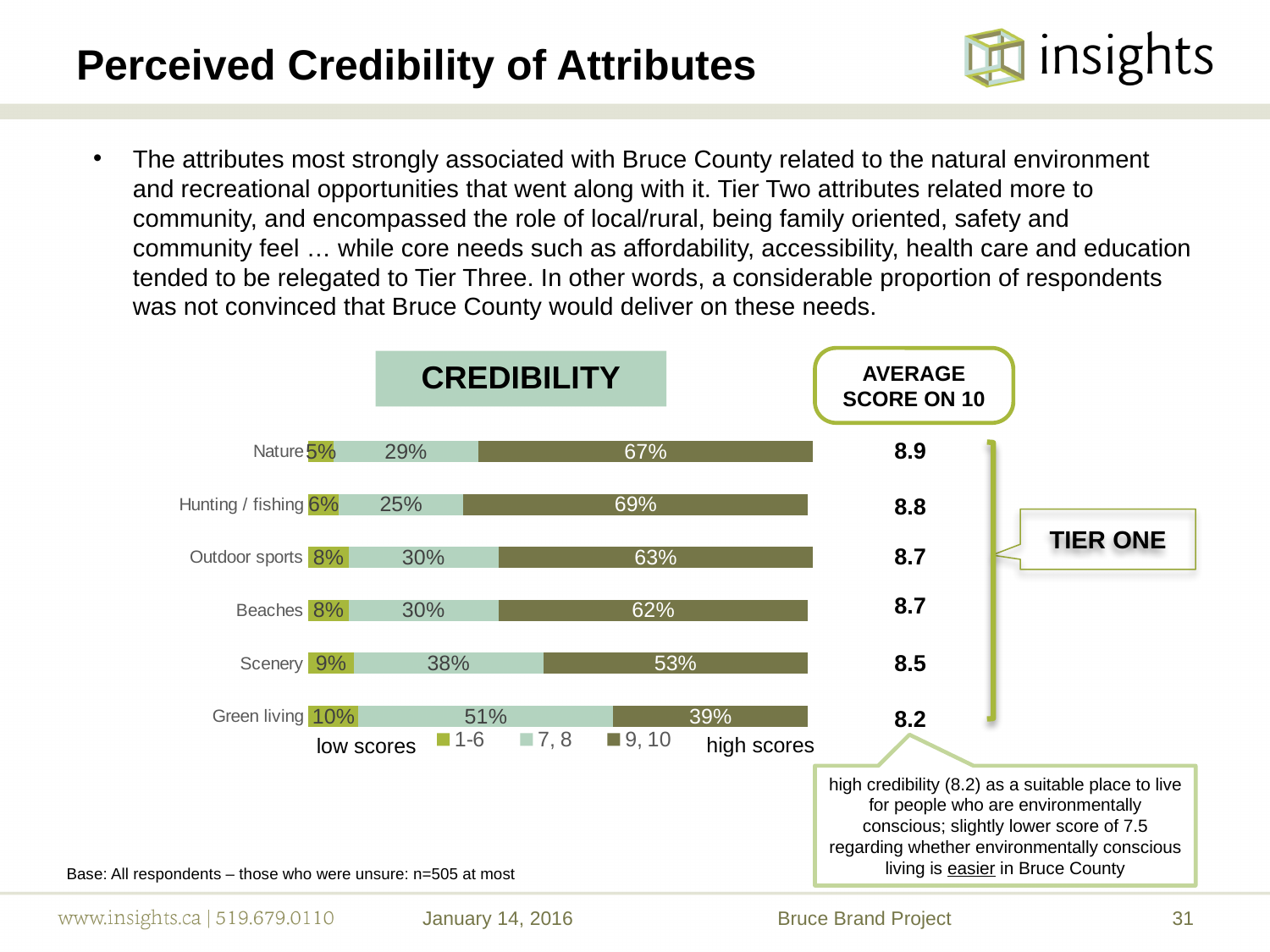
What percentage of respondents gave Nature a score of 9 or 10? 67% Which has a larger 7, 8 share: Scenery or Beaches? Scenery Which attribute has the highest share of 9, 10 scores? Hunting / fishing What percentage of respondents gave Scenery a score of 1-6? 9% What is the difference between the 9, 10 share for Nature and for Scenery? 14% How many series does the legend list? 3 What percentage of respondents gave Green living a score of 7 or 8? 51% Which attribute has the highest share of 1-6 scores? Green living What kind of chart is shown on the slide? Stacked bar chart Which attribute has the lowest share of 9, 10 scores? Green living How many attributes are shown in the chart? 6 What is the average score on 10 shown for Outdoor sports? 8.7